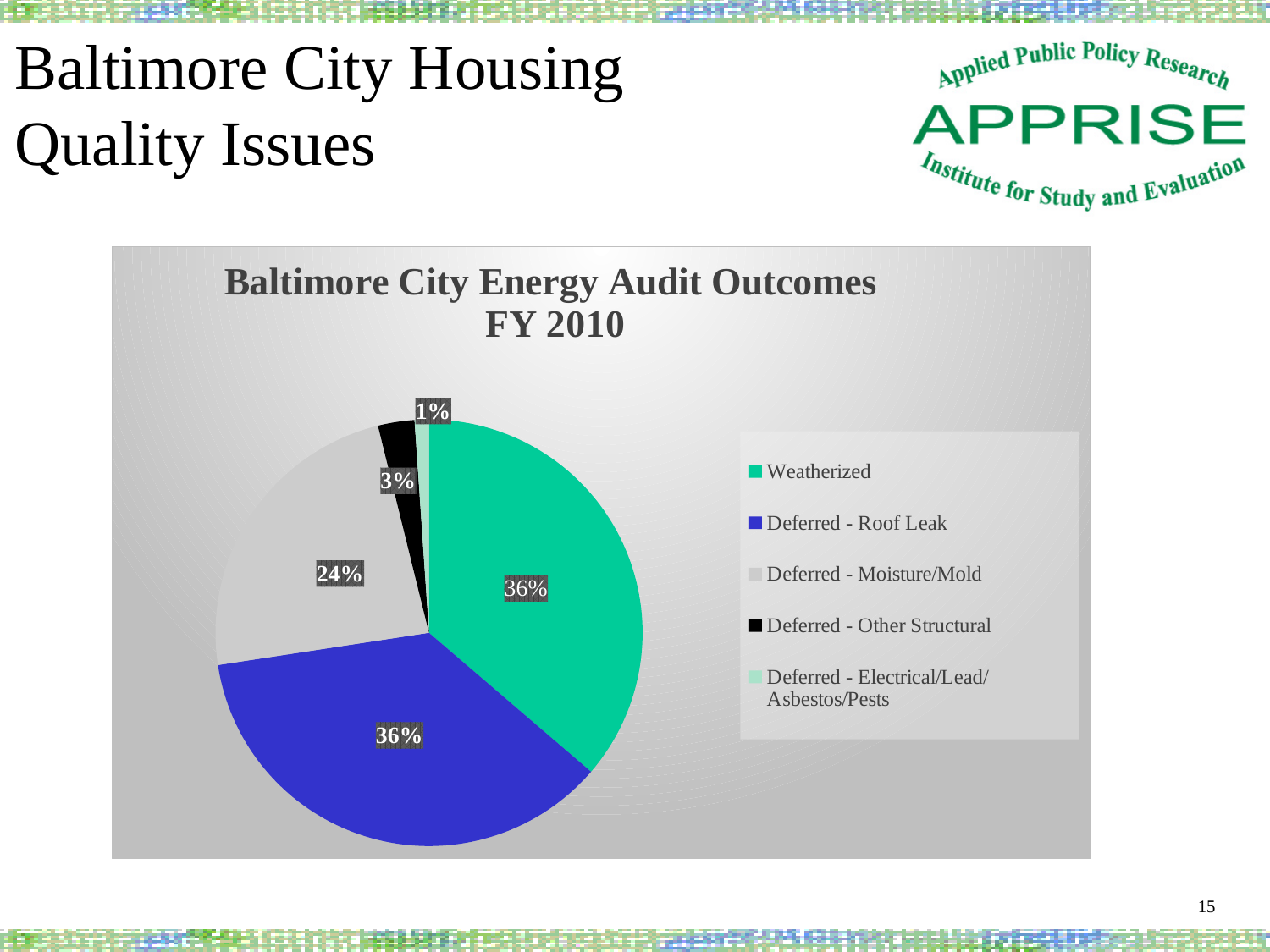
What type of chart is shown on the slide? Pie chart Which category has the smallest slice of the pie? Deferred - Electrical/Lead/Asbestos/Pests What percentage is shown for Deferred - Other Structural? 3% Which is larger: Deferred - Moisture/Mold or Deferred - Other Structural? Deferred - Moisture/Mold What is the value for Deferred - Roof Leak? 36% What is the difference in percentage points between Deferred - Moisture/Mold and Deferred - Other Structural? 21 percentage points What share of the pie is Deferred - Moisture/Mold? 24% What is the title of the chart? Baltimore City Energy Audit Outcomes FY 2010 What percentage of the pie is Weatherized? 36% How many entries does the legend list? 5 How many categories are shown in the pie chart? 5 What percentage is shown for Deferred - Electrical/Lead/Asbestos/Pests? 1%